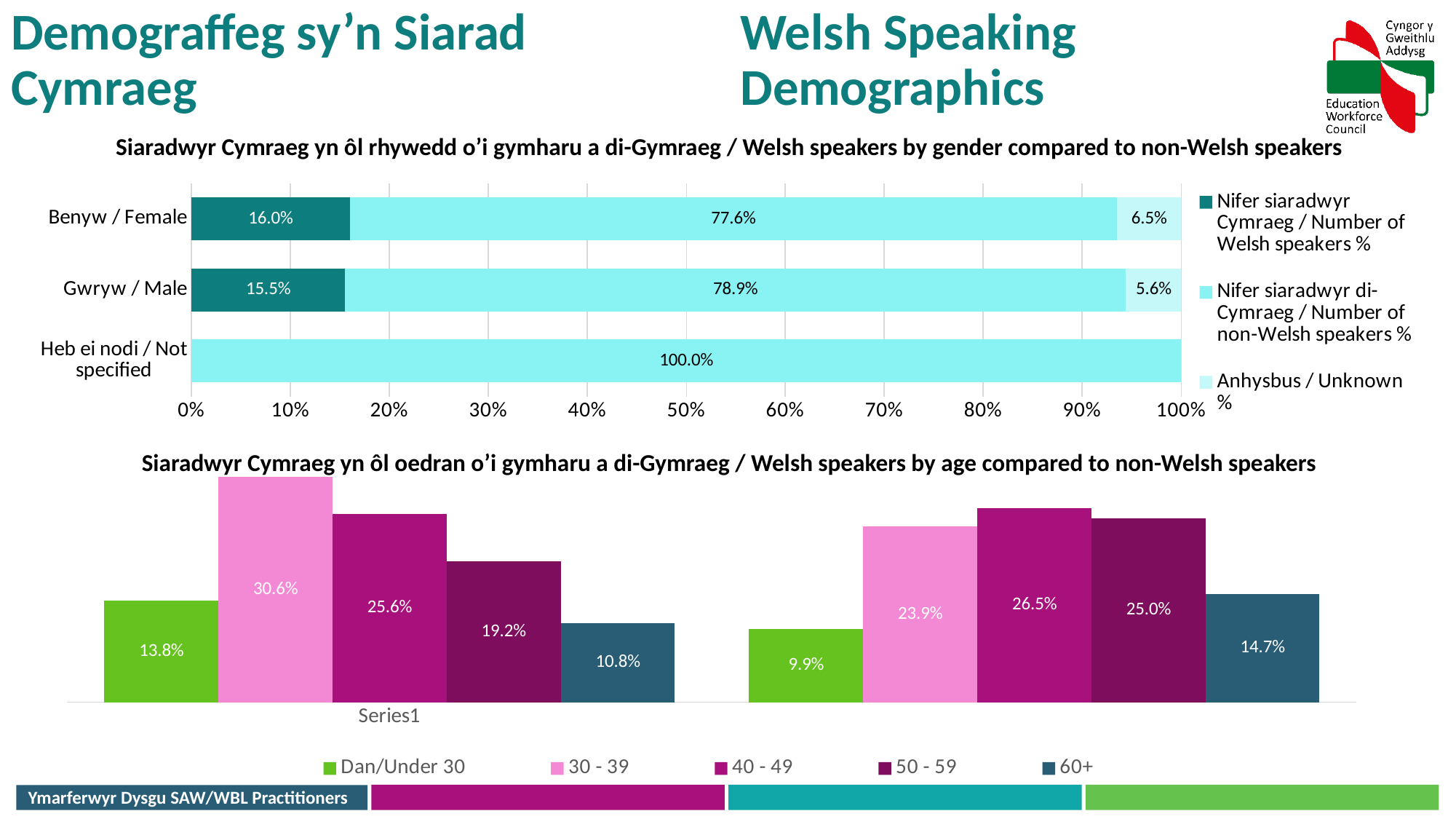
In the top chart (Welsh speakers by gender), which gender has the higher Unknown percentage, Female or Male? Benyw / Female What kind of chart is the top chart (Welsh speakers by gender)? Stacked bar chart In the bottom chart (Welsh speakers by age), which age group has the lowest value in the left group of bars (Series1)? 60+ In the top chart (Welsh speakers by gender), what percentage of females are Welsh speakers? 16.0% In the bottom chart (Welsh speakers by age), what is the value for the 30 - 39 age group in the left group of bars (Series1)? 30.6% In the bottom chart (Welsh speakers by age), how many age groups does the legend list? 5 In the top chart (Welsh speakers by gender), what is the difference between the female and male Welsh speaker percentages? 0.5% In the top chart (Welsh speakers by gender), what is the Unknown percentage for Benyw / Female? 6.5% In the bottom chart (Welsh speakers by age), which age group has the highest value in the right group of bars? 40 - 49 In the bottom chart (Welsh speakers by age), what is the difference between the 60+ values in the right group and the left group? 3.9% In the top chart (Welsh speakers by gender), how many series does the legend list? 3 In the top chart (Welsh speakers by gender), what is the non-Welsh speakers percentage for Gwryw / Male? 78.9%